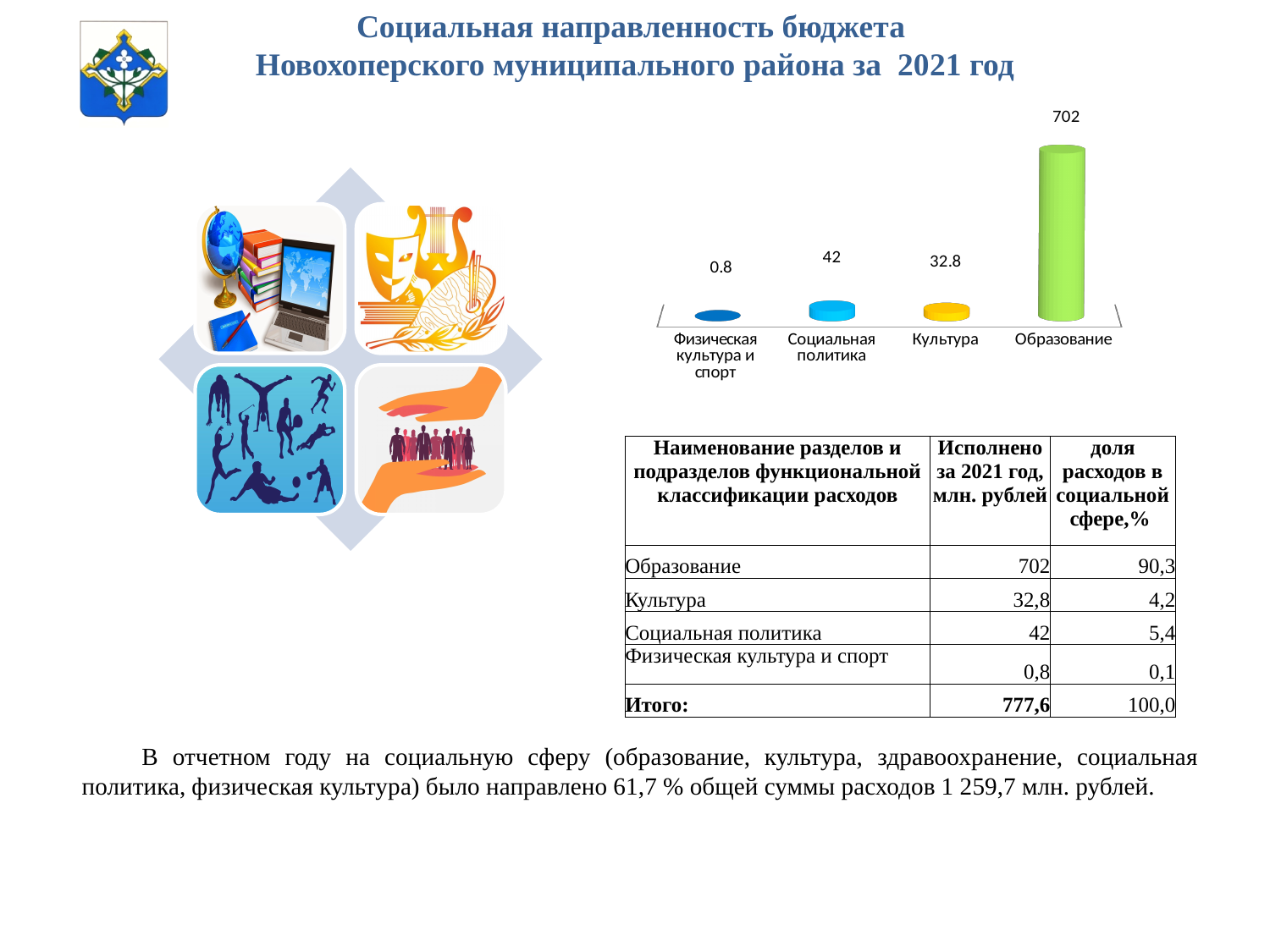
What kind of chart is shown on the slide? bar chart Which category has the lowest value in the chart? Физическая культура и спорт What is the difference between the values for Социальная политика and Культура in the chart? 9.2 What is the value shown for Физическая культура и спорт in the chart? 0.8 What is the value shown for Образование in the chart? 702 Which is larger in the chart, the value for Социальная политика or the value for Культура? Социальная политика What is the value shown for Социальная политика in the chart? 42 What is the total of all four values shown in the chart? 777.6 Which category has the highest value in the chart? Образование What is the value shown for Культура in the chart? 32.8 How many categories are shown in the chart? 4 What is the difference between the values for Образование and Социальная политика in the chart? 660